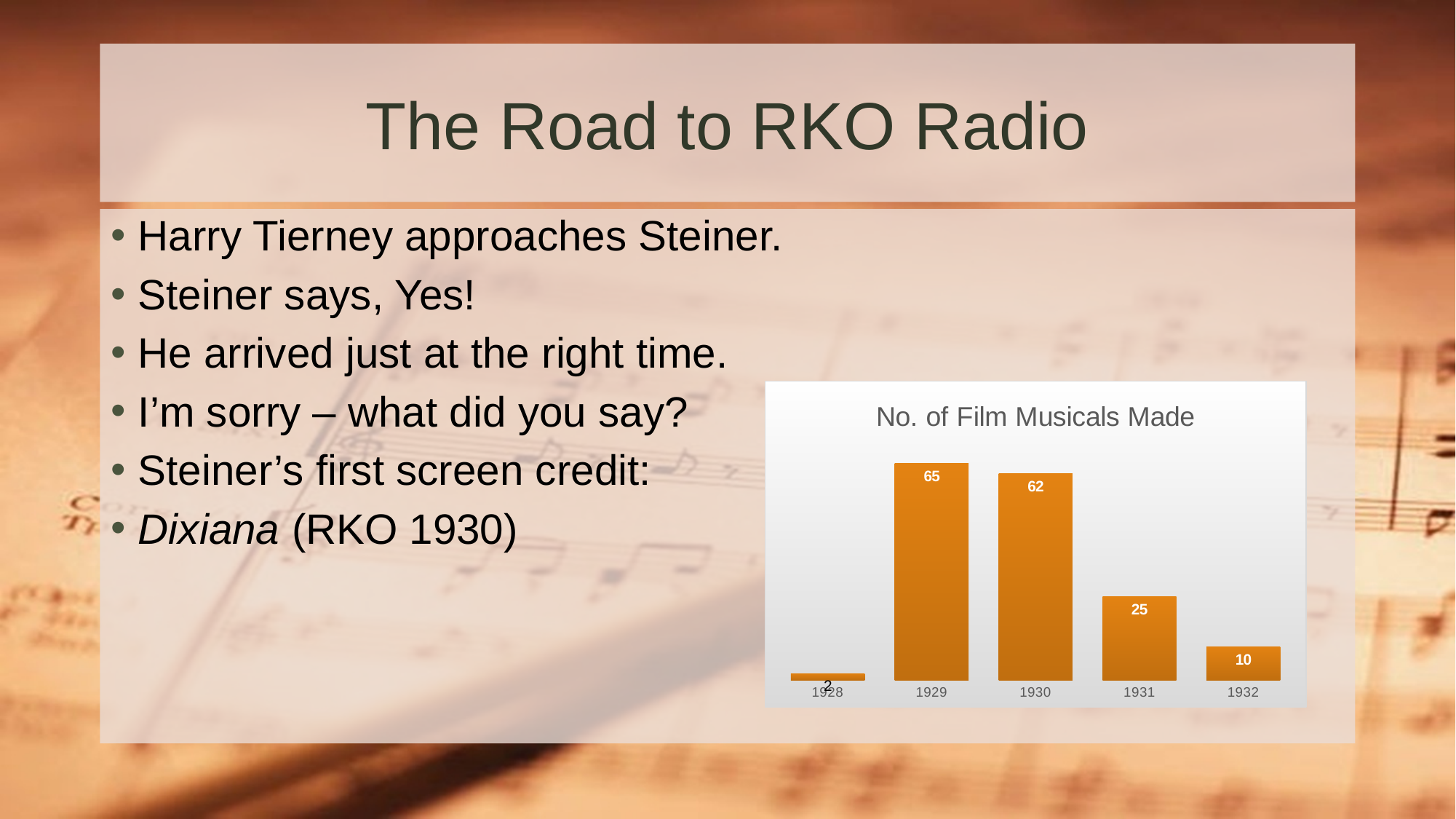
What is the title of the chart? No. of Film Musicals Made How many film musicals were made in 1931? 25 From 1929 to 1932, do the values rise or fall along the x axis? fall How many film musicals were made in 1932? 10 How many years are shown on the x axis of the chart? 5 What type of chart is shown on the slide? bar chart What is the difference between the number of film musicals made in 1929 and 1930? 3 Which year has the lowest number of film musicals made? 1928 Which year has the highest number of film musicals made? 1929 What is the difference between the number of film musicals made in 1930 and 1931? 37 Which year had more film musicals made, 1931 or 1932? 1931 How many film musicals were made in 1929? 65